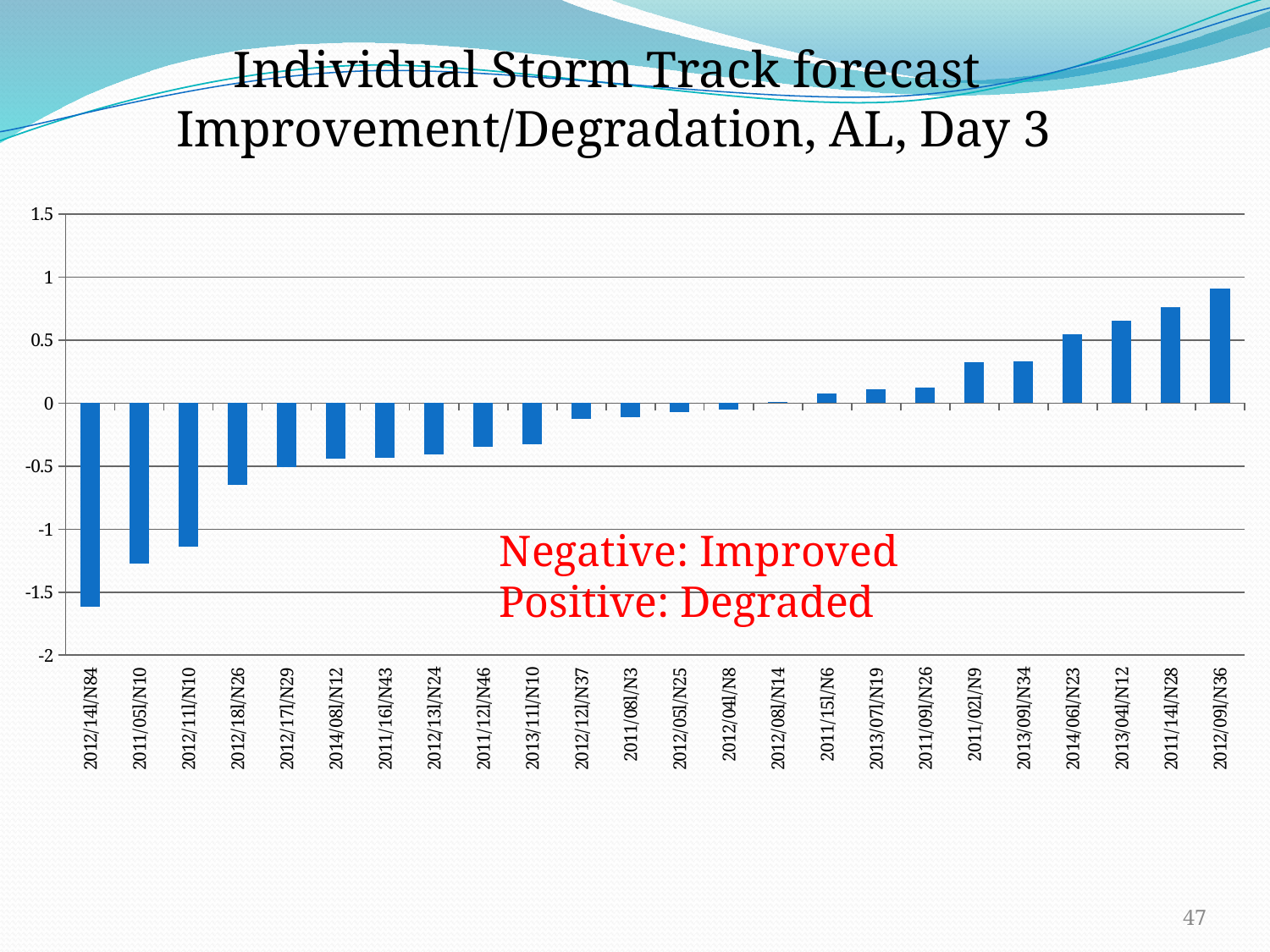
Do the bar values rise or fall moving from left to right along the x axis? rise Is the value for 2011/02l/N9 greater or less than 0.5? less Which storm has the lowest (most negative) value? 2012/14l/N84 Is the value for 2011/05l/N10 greater or less than -1? less Is the value for 2012/18l/N26 greater or less than -0.5? less What kind of chart is shown on the slide? bar chart Which storm has the highest value? 2012/09l/N36 How many storms (categories) are plotted on the x axis? 24 What is the title of the chart on the slide? Individual Storm Track forecast Improvement/Degradation, AL, Day 3 Which has the larger value, 2012/09l/N36 or 2011/14l/N28? 2012/09l/N36